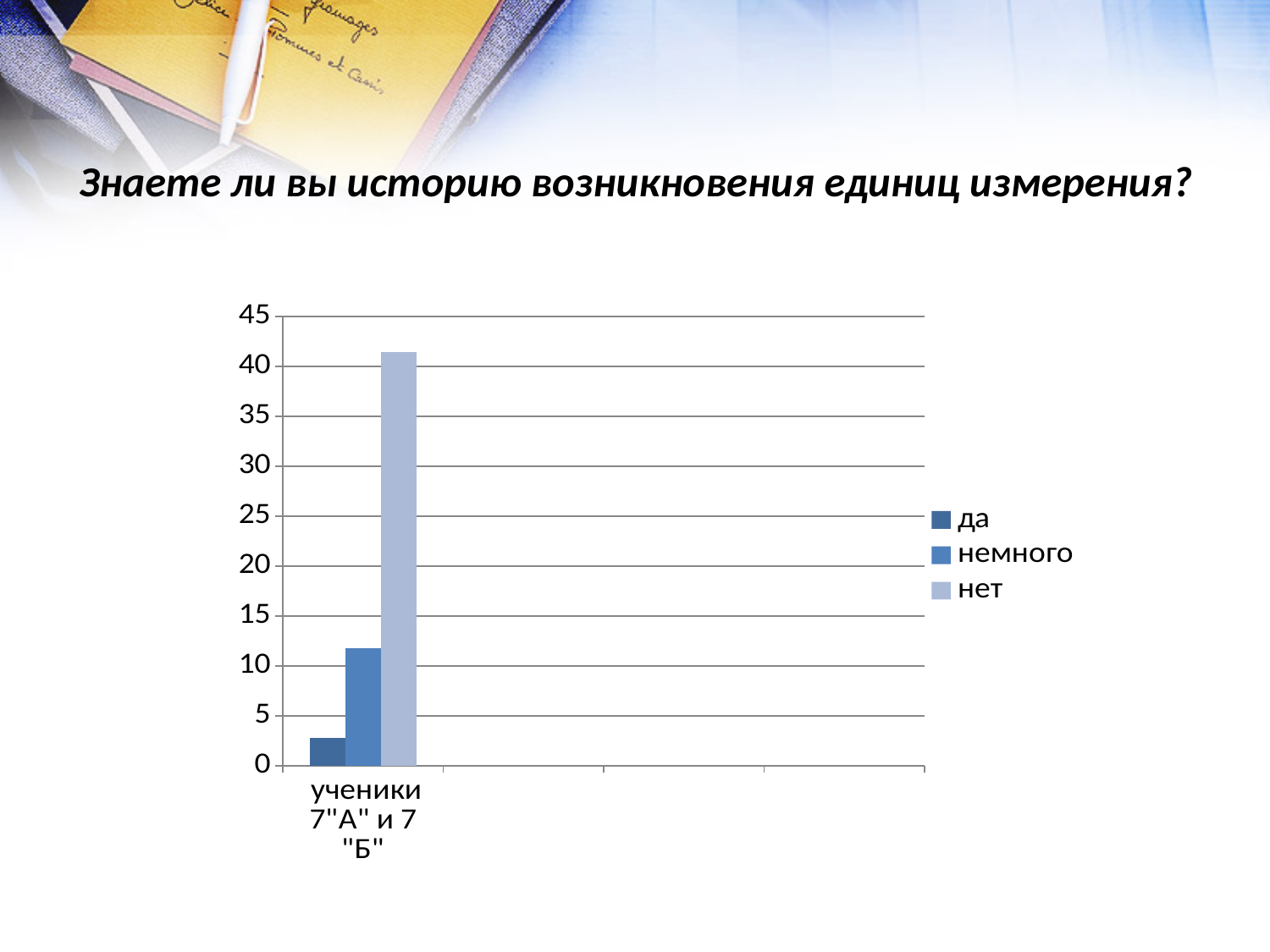
What is the title of the slide above the chart? Знаете ли вы историю возникновения единиц измерения? Which is larger, the value for "немного" or the value for "да"? немного Is the value for "да" greater or less than 5? less How many series does the legend list? 3 What kind of chart is shown on the slide? bar chart Which series has the lowest bar? да Is the value for "немного" greater or less than 10? greater Is the value for "нет" greater or less than 40? greater Which is larger, the value for "нет" or the value for "немного"? нет How many categories are shown on the x axis? 1 What are the three entries listed in the legend? да, немного, нет Which series has the highest bar? нет